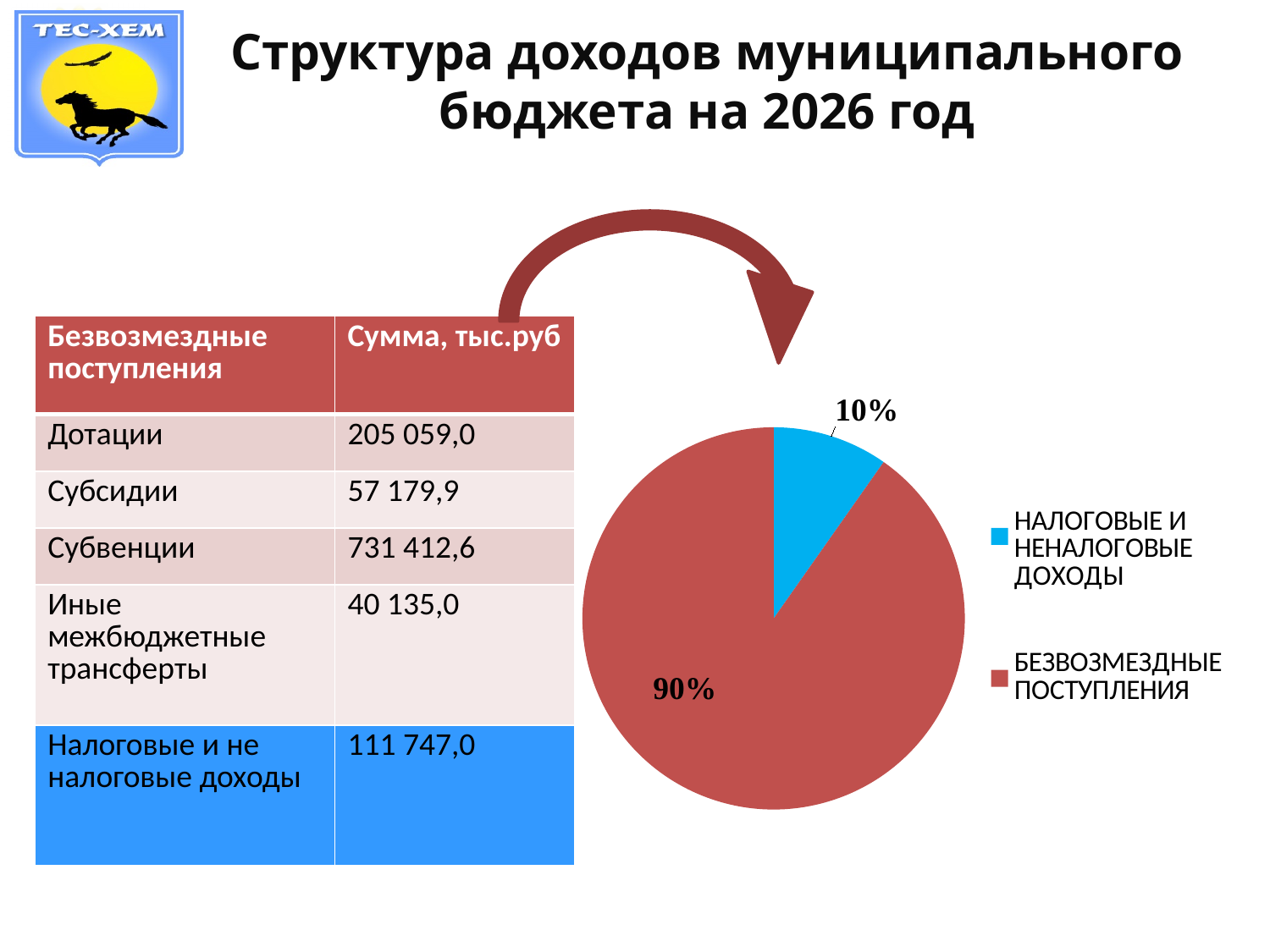
What share of the pie does БЕЗВОЗМЕЗДНЫЕ ПОСТУПЛЕНИЯ take? 90% How many entries does the legend of the pie chart list? 2 Which slice of the pie chart is the smallest? НАЛОГОВЫЕ И НЕНАЛОГОВЫЕ ДОХОДЫ What kind of chart is shown on the slide? pie chart What colour is the БЕЗВОЗМЕЗДНЫЕ ПОСТУПЛЕНИЯ slice in the pie chart? red How many slices does the pie chart have? 2 What share of the pie does НАЛОГОВЫЕ И НЕНАЛОГОВЫЕ ДОХОДЫ take? 10% By how many percentage points does the БЕЗВОЗМЕЗДНЫЕ ПОСТУПЛЕНИЯ slice exceed the НАЛОГОВЫЕ И НЕНАЛОГОВЫЕ ДОХОДЫ slice? 80 Which slice of the pie chart is the largest? БЕЗВОЗМЕЗДНЫЕ ПОСТУПЛЕНИЯ Which is larger in the pie chart: НАЛОГОВЫЕ И НЕНАЛОГОВЫЕ ДОХОДЫ or БЕЗВОЗМЕЗДНЫЕ ПОСТУПЛЕНИЯ? БЕЗВОЗМЕЗДНЫЕ ПОСТУПЛЕНИЯ What colour is the НАЛОГОВЫЕ И НЕНАЛОГОВЫЕ ДОХОДЫ slice in the pie chart? blue